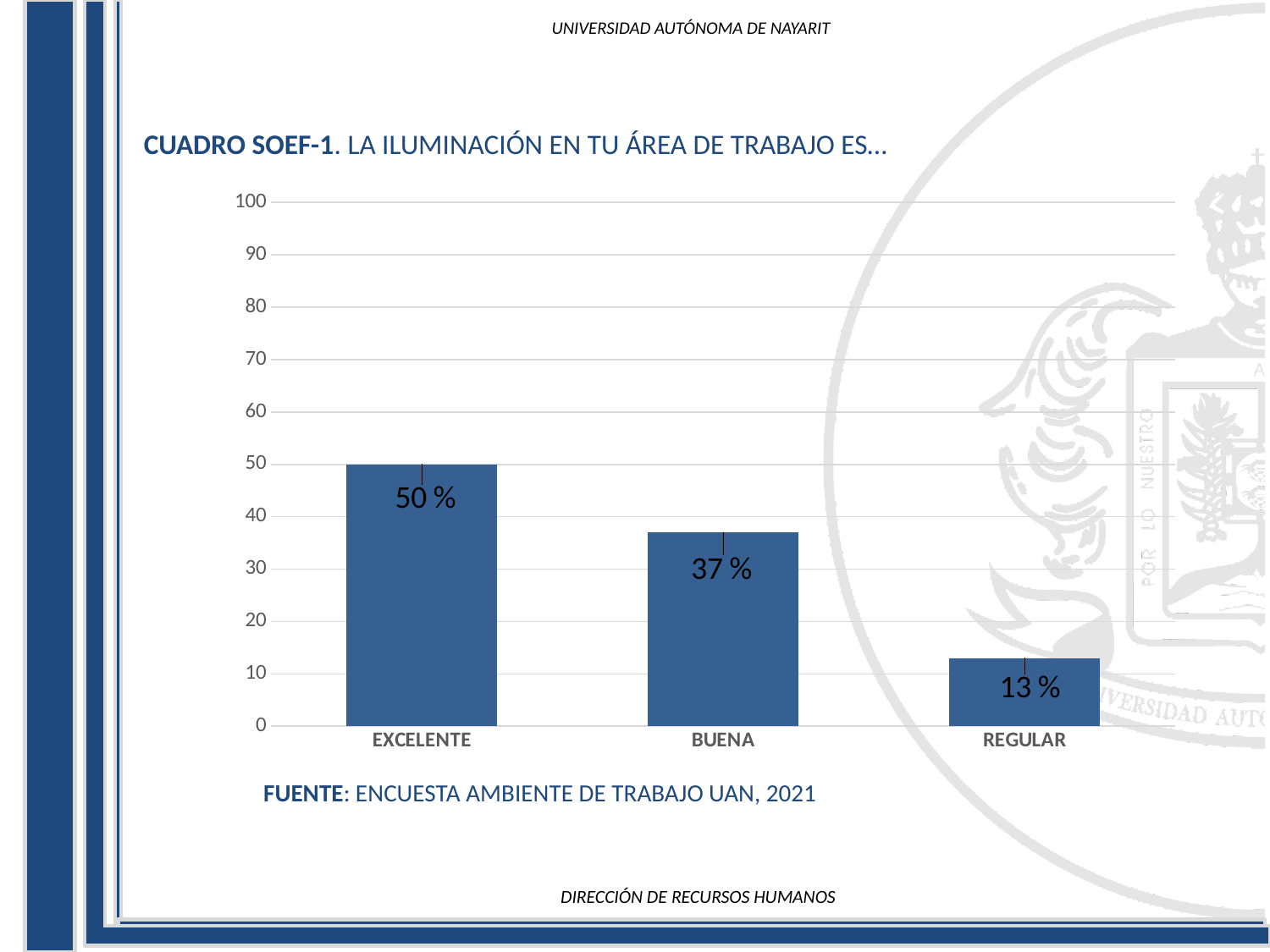
How many categories are shown on the x axis? 3 What kind of chart is shown on the slide? bar chart Which category has the highest value? EXCELENTE What is the value for BUENA? 37 % Which is larger, the value for BUENA or the value for REGULAR? BUENA What is the value for EXCELENTE? 50 % Is the value for BUENA greater or less than 40? less Which category has the lowest value? REGULAR What is the value for REGULAR? 13 % Do the values rise or fall from EXCELENTE to REGULAR along the x axis? fall What is the difference between the values for BUENA and REGULAR? 24 % What is the difference between the values for EXCELENTE and BUENA? 13 %